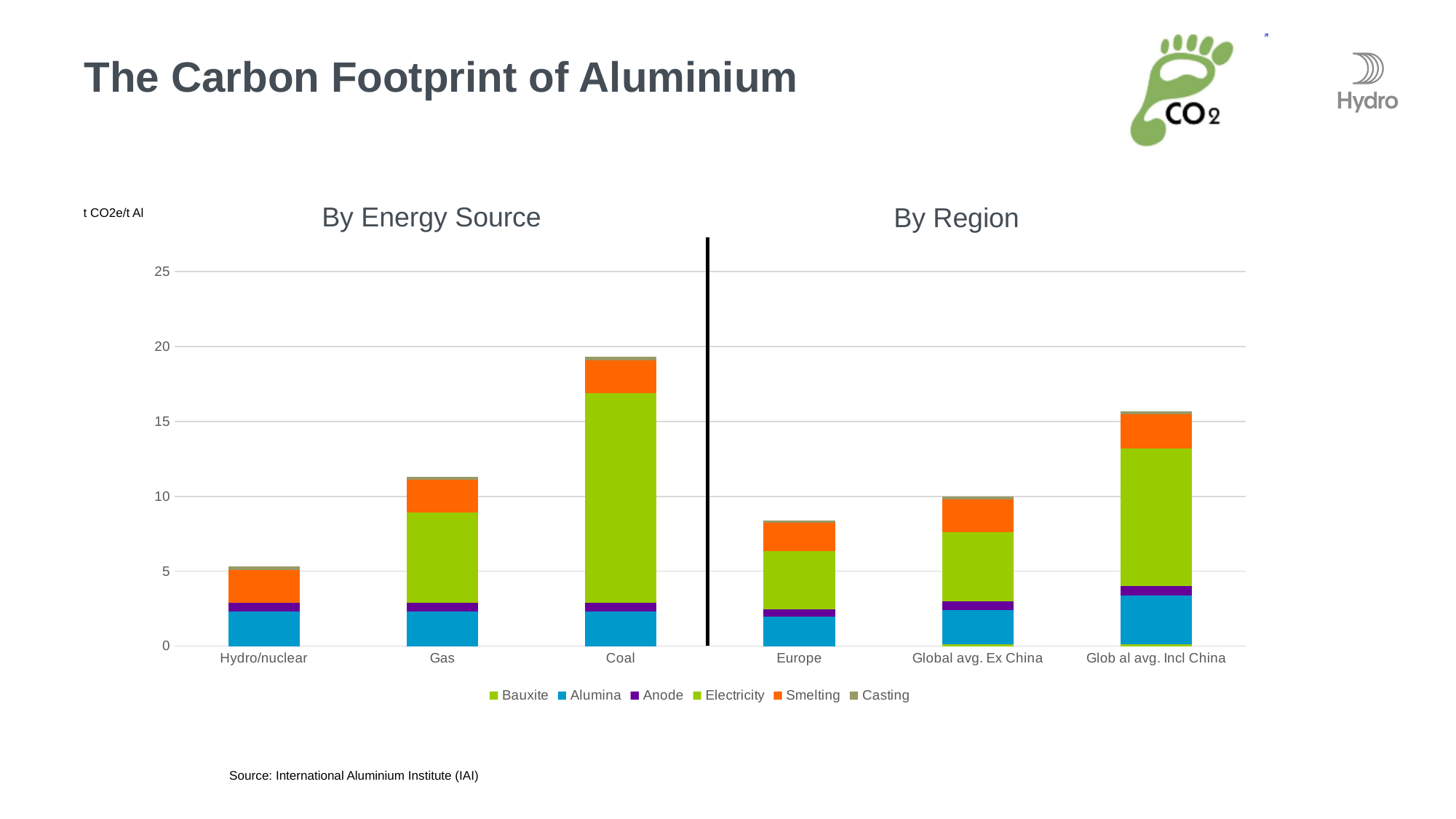
Which category has the shortest stacked bar? Hydro/nuclear Is the total for Hydro/nuclear greater or less than 10? less How many series does the chart's legend list? 6 What unit is shown on the y axis of the chart? t CO2e/t Al Is the total for Global avg. Incl China greater or less than 10? greater Is the total for Coal greater or less than 15? greater How many categories are shown along the x axis of the chart? 6 Which has the larger total, Europe or Global avg. Incl China? Global avg. Incl China Which has the larger total, Gas or Coal? Coal What kind of chart is shown on the slide? Stacked bar chart Which category has the tallest stacked bar? Coal